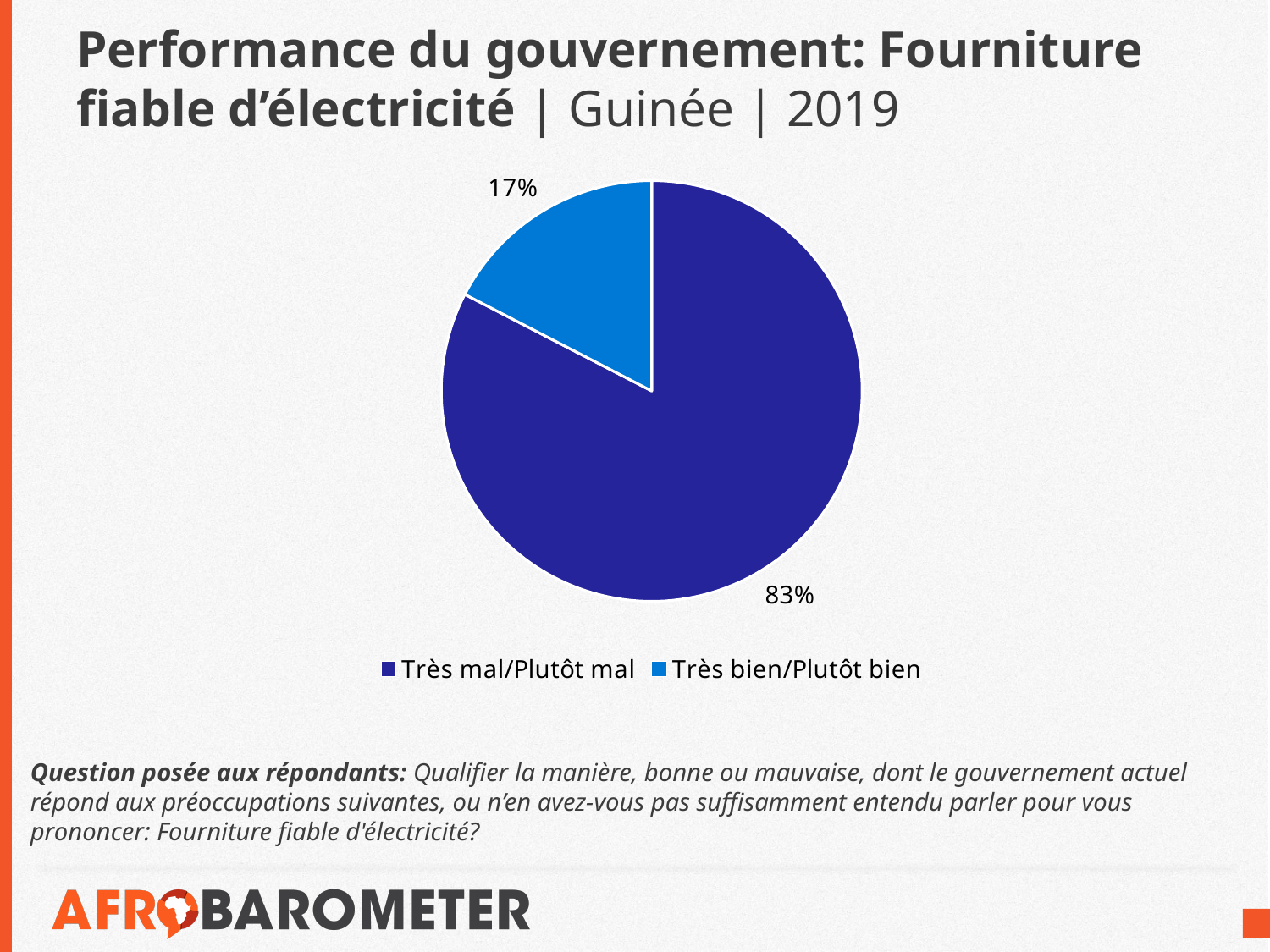
What colour is the "Très bien/Plutôt bien" slice? light blue What percentage of respondents answered "Très mal/Plutôt mal"? 83% What percentage of respondents answered "Très bien/Plutôt bien"? 17% What share of the pie does the "Très bien/Plutôt bien" slice represent? 17% What kind of chart is shown on the slide? pie chart What is the difference in percentage points between "Très mal/Plutôt mal" and "Très bien/Plutôt bien"? 66 percentage points Which is larger: the share for "Très bien/Plutôt bien" or the share for "Très mal/Plutôt mal"? Très mal/Plutôt mal Which category has the smallest share of the pie? Très bien/Plutôt bien Which country and year does the chart title refer to? Guinée, 2019 How many slices does the pie chart have? 2 Which category has the largest share of the pie? Très mal/Plutôt mal How many entries does the legend list? 2